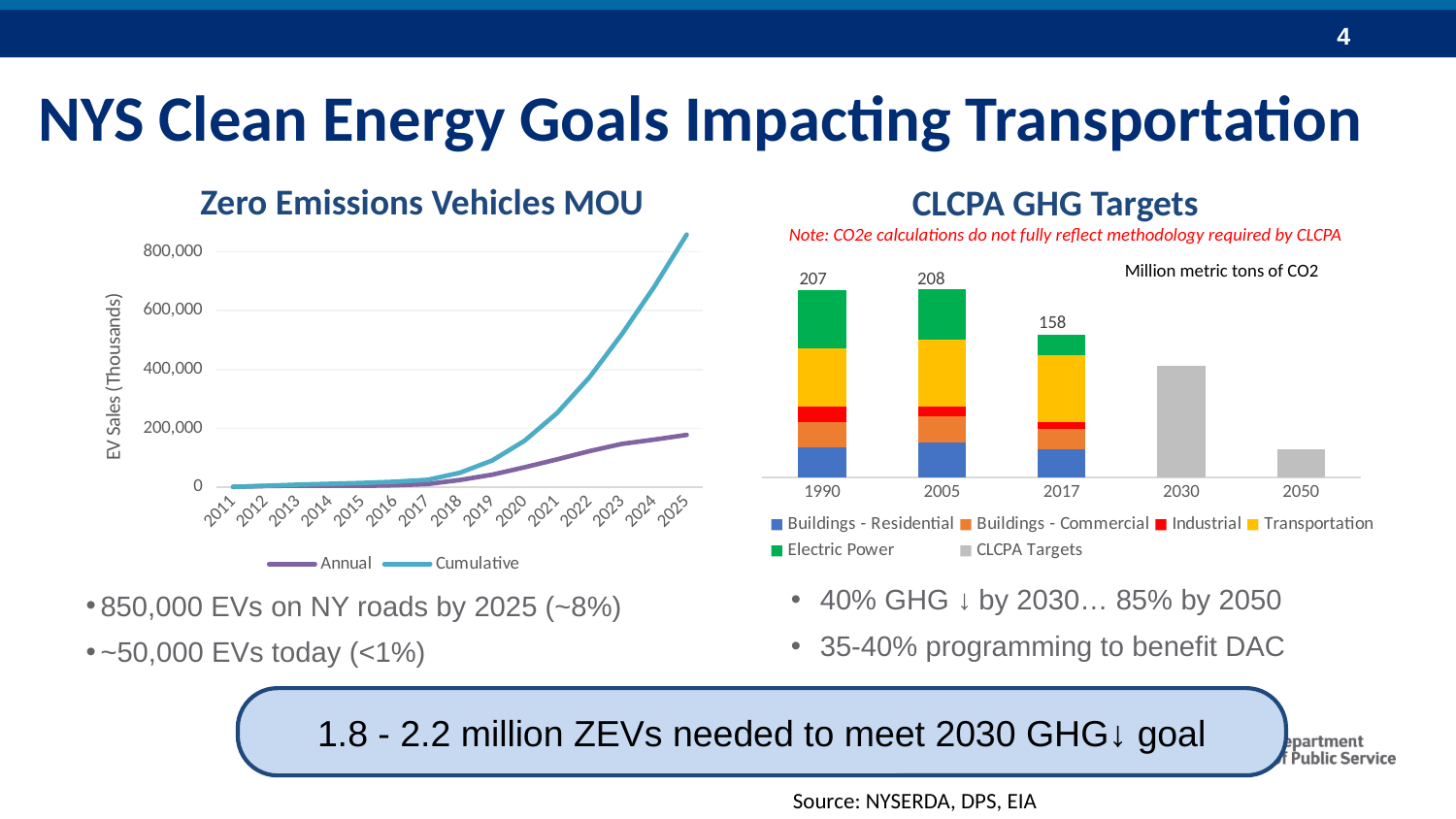
On the Zero Emissions Vehicles MOU chart, is the Cumulative value for 2025 greater or less than 800,000? greater On the Zero Emissions Vehicles MOU chart, does the Cumulative line rise or fall from 2011 to 2025? Rise On the CLCPA GHG Targets chart, what is the total for the 2017 bar? 158 On the CLCPA GHG Targets chart, which of the labeled years (1990, 2005, 2017) has the lowest total? 2017 On the CLCPA GHG Targets chart, what is the total for the 1990 bar? 207 On the Zero Emissions Vehicles MOU chart, how many years are shown on the x axis? 15 On the CLCPA GHG Targets chart, which bar is taller, 2030 or 2050? 2030 On the Zero Emissions Vehicles MOU chart, how many series does the legend list? 2 On the CLCPA GHG Targets chart, how many series does the legend list? 6 On the Zero Emissions Vehicles MOU chart, what kind of chart is shown? Line chart On the Zero Emissions Vehicles MOU chart, is the Annual value for 2025 greater or less than 200,000? less On the CLCPA GHG Targets chart, what is the difference between the 2005 total and the 2017 total? 50